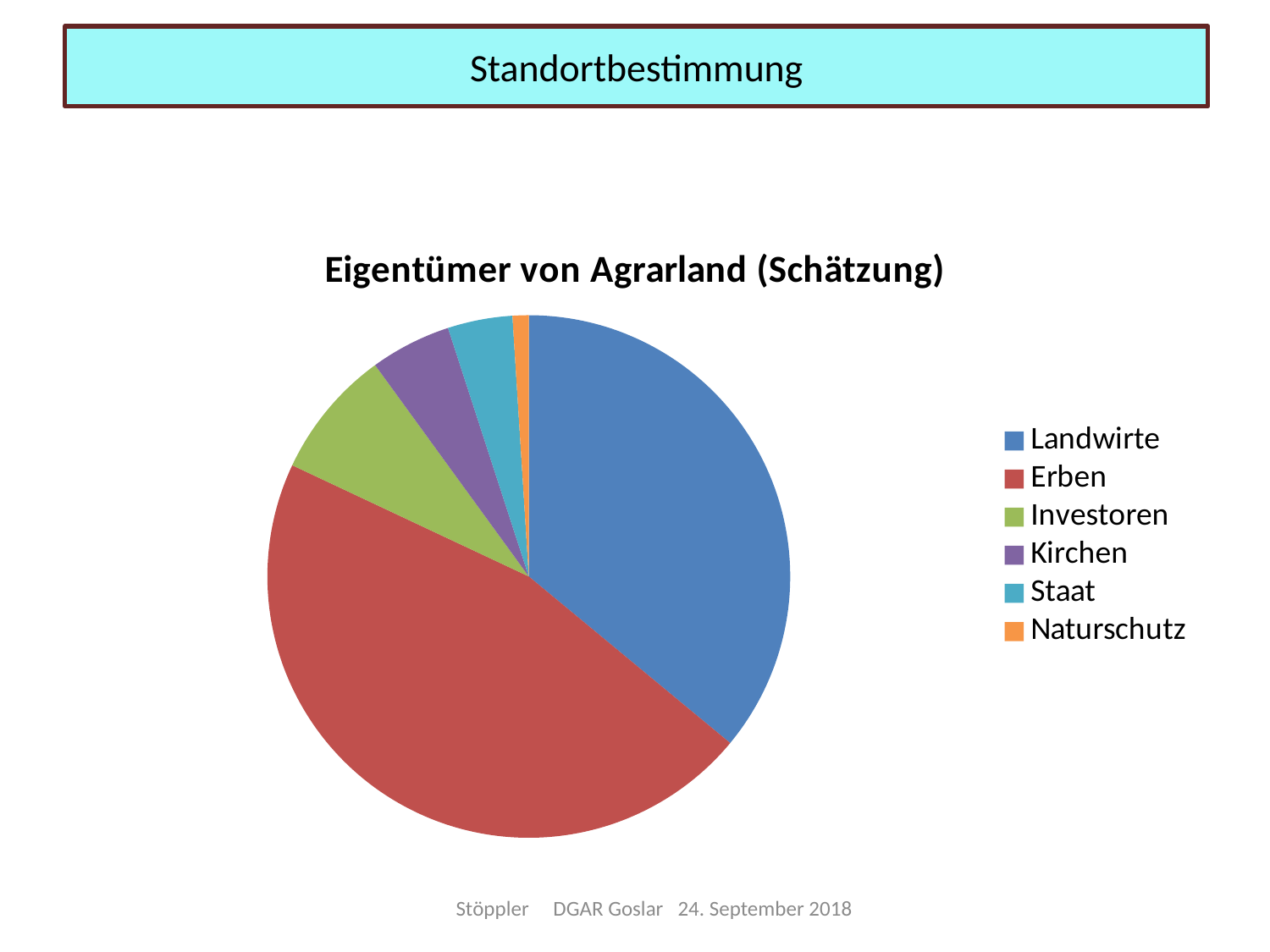
Which slice is larger, Staat or Naturschutz? Staat Which category is shown in orange in the legend? Naturschutz Which category has the smallest slice of the pie? Naturschutz What is the title of the chart? Eigentümer von Agrarland (Schätzung) Which category has the largest slice of the pie? Erben Which slice is larger, Landwirte or Investoren? Landwirte Which category has the second-largest slice of the pie? Landwirte Which slice is larger, Investoren or Kirchen? Investoren What kind of chart is shown on the slide? pie chart How many categories does the pie chart have? 6